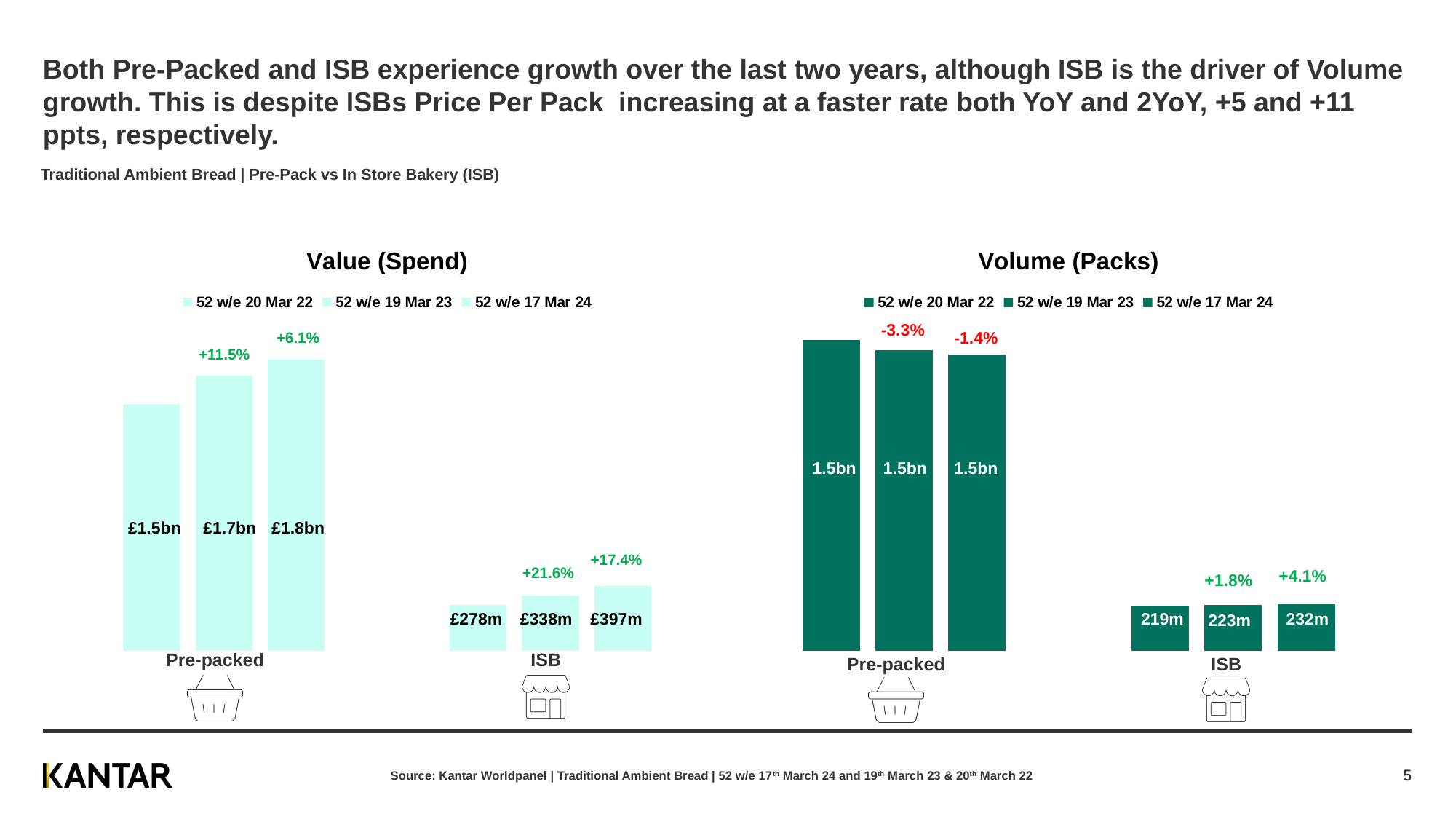
In the Value (Spend) chart, which is larger: Pre-packed in 52 w/e 20 Mar 22 or ISB in 52 w/e 17 Mar 24? Pre-packed in 52 w/e 20 Mar 22 In the Value (Spend) chart, what is the difference between the ISB values for 52 w/e 17 Mar 24 and 52 w/e 20 Mar 22? £119m In the Value (Spend) chart, do the ISB values rise or fall across the three periods? Rise In the Volume (Packs) chart, what is the value for Pre-packed in 52 w/e 19 Mar 23? 1.5bn In the Volume (Packs) chart, what is the value for ISB in 52 w/e 17 Mar 24? 232m In the Volume (Packs) chart, which ISB period has the lowest value? 52 w/e 20 Mar 22 In the Value (Spend) chart, what is the value for ISB in 52 w/e 20 Mar 22? £278m What kind of chart is the Value (Spend) chart? Bar chart How many series does the legend of the Volume (Packs) chart list? 3 In the Value (Spend) chart, which ISB period has the highest value? 52 w/e 17 Mar 24 In the Volume (Packs) chart, what is the difference between the ISB values for 52 w/e 17 Mar 24 and 52 w/e 19 Mar 23? 9m In the Value (Spend) chart, what is the value for Pre-packed in 52 w/e 17 Mar 24? £1.8bn